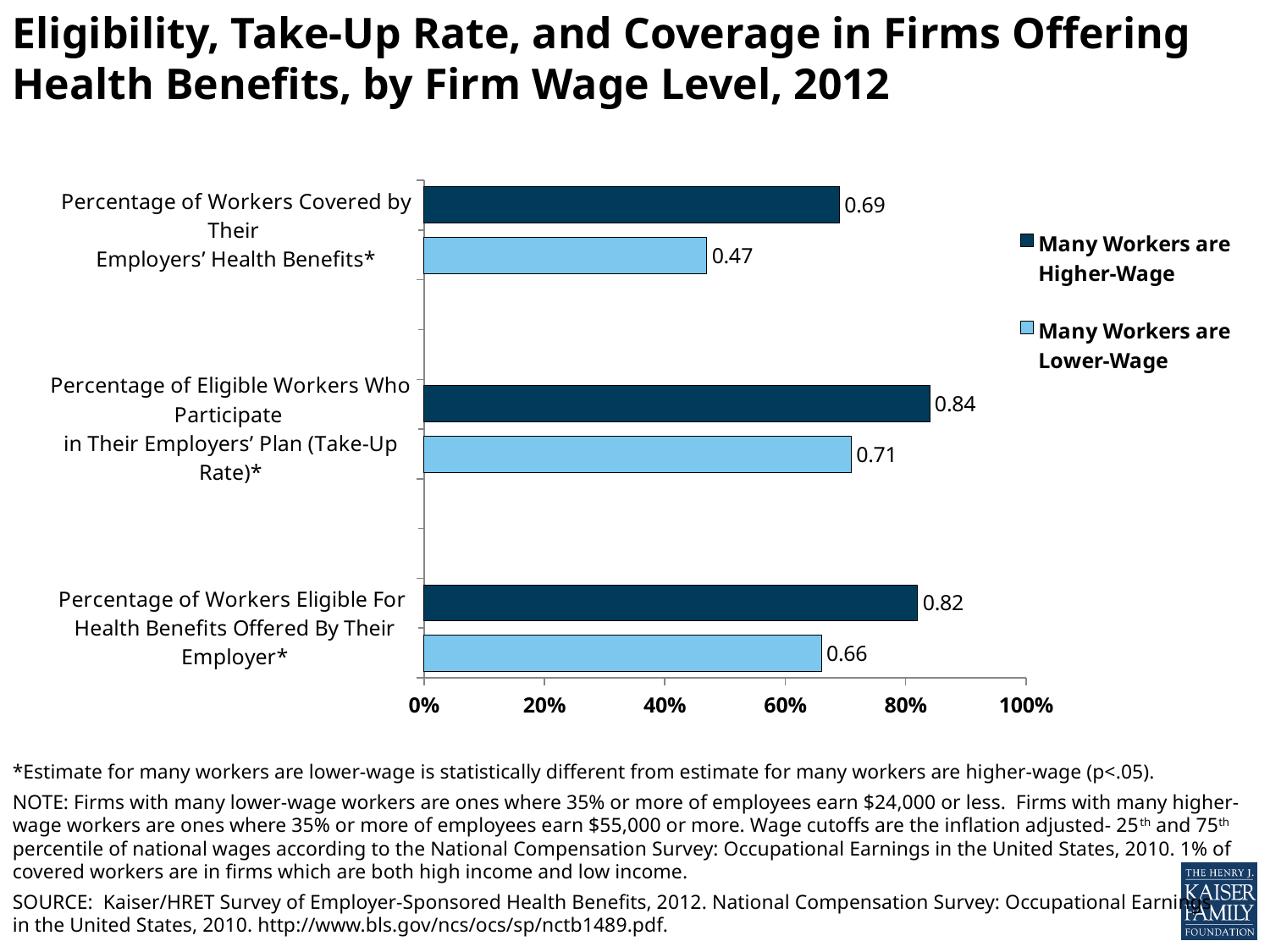
What is the difference between the higher-wage and lower-wage values for Percentage of Workers Eligible For Health Benefits Offered By Their Employer? 0.16 How many series does the legend list? 2 Is the value for 'Many Workers are Lower-Wage' for Percentage of Workers Covered by Their Employers' Health Benefits greater or less than 60%? less What kind of chart is shown on the slide? Bar chart What is the value for 'Many Workers are Higher-Wage' for Percentage of Workers Covered by Their Employers' Health Benefits? 0.69 What is the value for 'Many Workers are Lower-Wage' for Percentage of Workers Eligible For Health Benefits Offered By Their Employer? 0.66 Which category has the lowest value for 'Many Workers are Lower-Wage'? Percentage of Workers Covered by Their Employers' Health Benefits What is the take-up rate (Percentage of Eligible Workers Who Participate in Their Employers' Plan) for firms with many lower-wage workers? 0.71 How many categories are shown on the chart? 3 Which is larger: the take-up rate for higher-wage firms or the eligibility percentage for higher-wage firms? Take-up rate for higher-wage firms Which category has the highest value for 'Many Workers are Higher-Wage'? Percentage of Eligible Workers Who Participate in Their Employers' Plan (Take-Up Rate) What is the difference between the higher-wage and lower-wage values for Percentage of Workers Covered by Their Employers' Health Benefits? 0.22